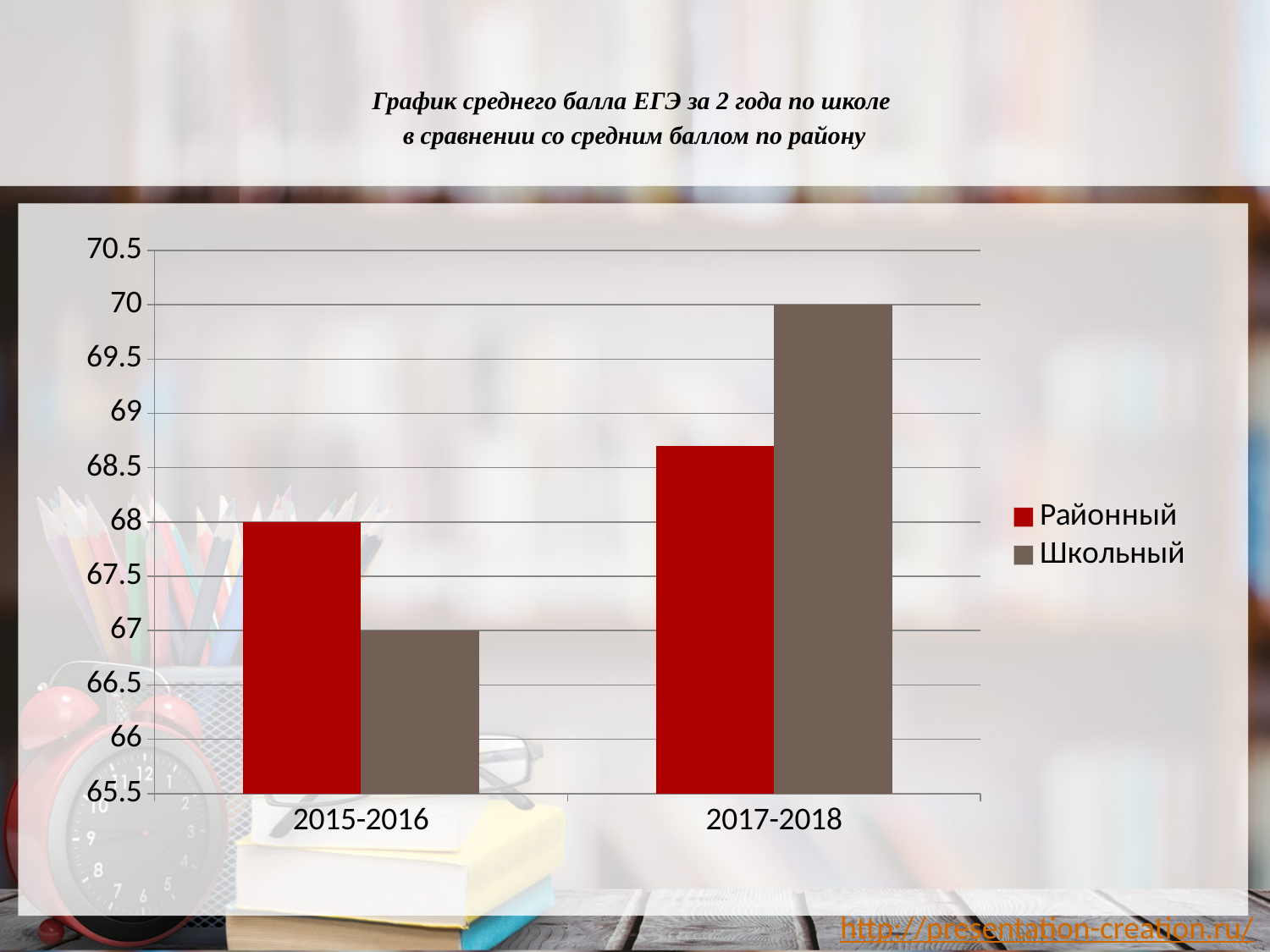
What is the value for Районный in 2015-2016? 68 Which is larger in 2017-2018, Районный or Школьный? Школьный Is the value for Районный in 2017-2018 greater or less than 68.5? greater Does the Школьный value rise or fall from 2015-2016 to 2017-2018? rise What is the value for Школьный in 2017-2018? 70 Which category has the highest Школьный value? 2017-2018 What is the value for Школьный in 2015-2016? 67 Is the value for Районный in 2017-2018 greater or less than 69? less What type of chart is shown on the slide? bar chart How many categories are shown on the x axis? 2 How many series does the legend list? 2 What is the difference between Районный and Школьный in 2015-2016? 1